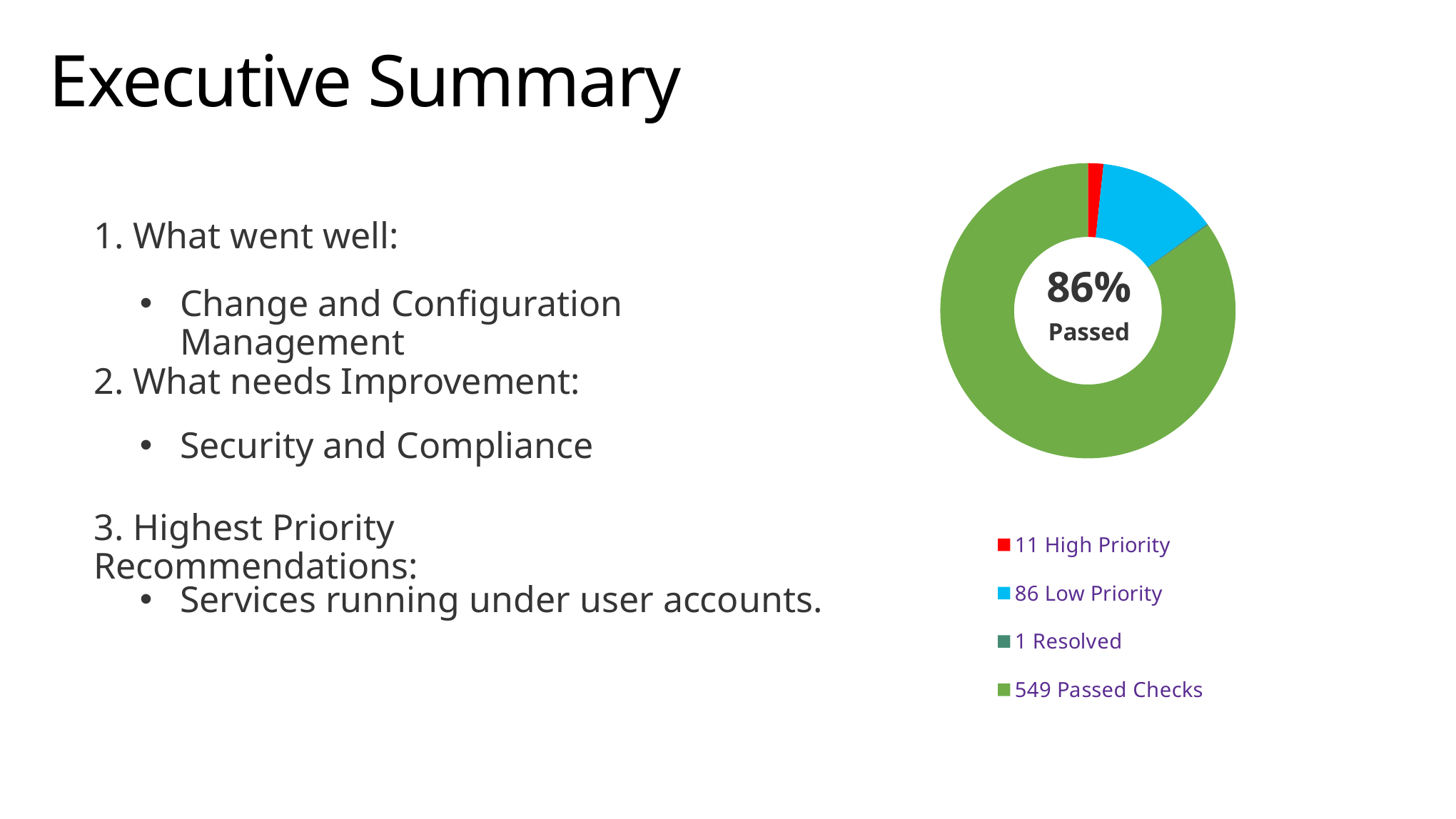
What is the difference between the Low Priority and High Priority counts? 75 How many Passed Checks does the chart legend show? 549 What is the total of all four values listed in the chart legend? 647 Which category has the smallest value in the chart? Resolved Which category has the largest value in the chart? Passed Checks How many categories does the chart legend list? 4 Which is larger, the High Priority count or the Low Priority count? Low Priority What kind of chart is shown on the slide? pie chart (donut) How many checks are listed as High Priority in the chart legend? 11 How many checks are listed as Low Priority in the chart legend? 86 What percentage is printed in the centre of the donut chart? 86% How many checks are listed as Resolved in the chart legend? 1